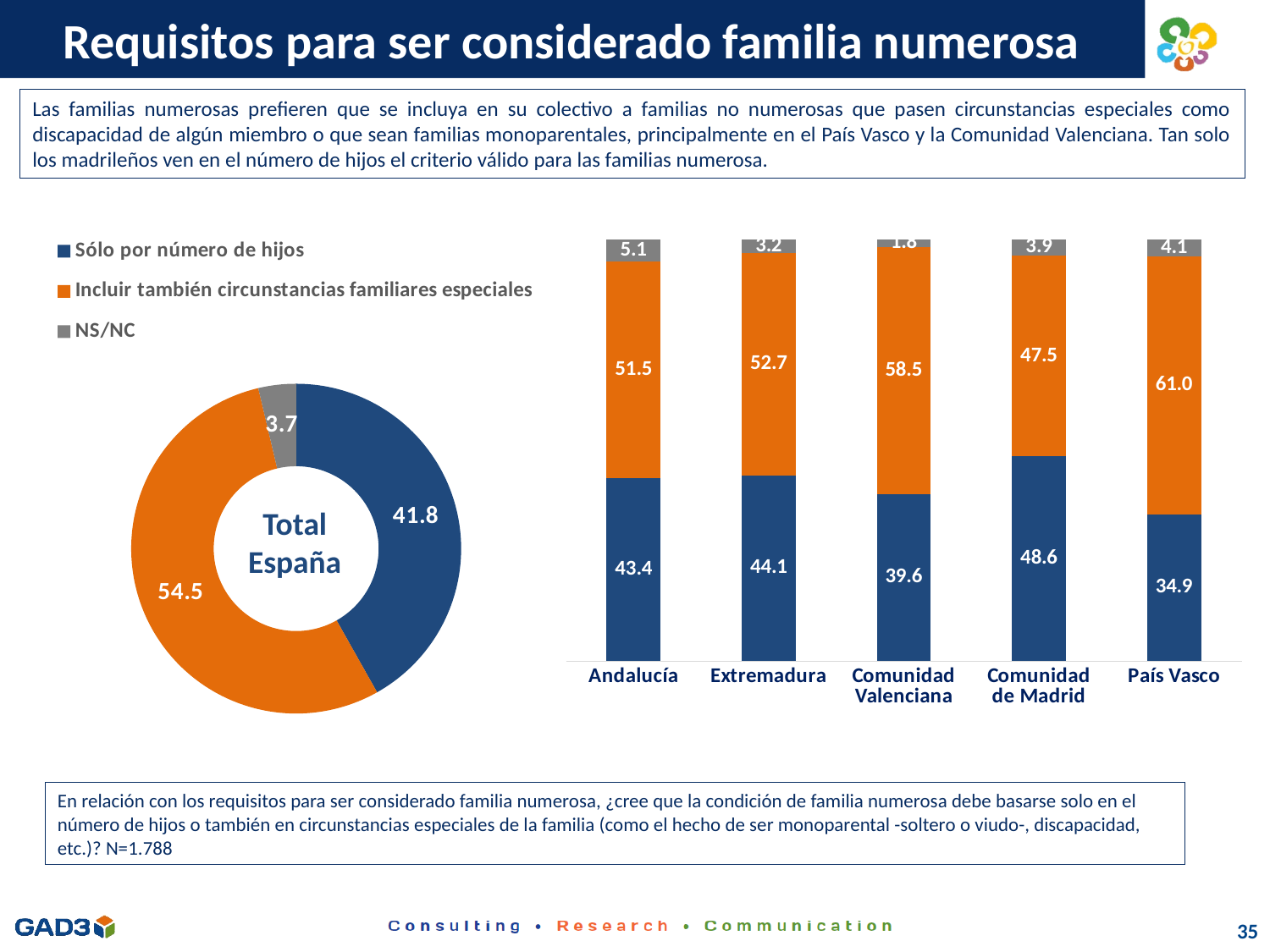
In the stacked bar chart on the right, what is the value for 'Sólo por número de hijos' in País Vasco? 34.9 In the stacked bar chart on the right, what is the value for 'Incluir también circunstancias familiares especiales' in Comunidad Valenciana? 58.5 In the stacked bar chart on the right, which region has the lowest value for 'Incluir también circunstancias familiares especiales'? Comunidad de Madrid What kind of chart is the chart on the right of the slide? Stacked bar chart How many regions are shown on the x axis of the stacked bar chart on the right? 5 In the stacked bar chart on the right, what is the difference between the 'Incluir también circunstancias familiares especiales' values for País Vasco and Comunidad de Madrid? 13.5 In the donut chart labelled Total España, what is the value for 'Sólo por número de hijos'? 41.8 In the stacked bar chart on the right, which region has the highest value for 'Sólo por número de hijos'? Comunidad de Madrid In the donut chart labelled Total España, what is the value for NS/NC? 3.7 In the stacked bar chart on the right, which is larger in Comunidad de Madrid: 'Sólo por número de hijos' or 'Incluir también circunstancias familiares especiales'? Sólo por número de hijos In the donut chart labelled Total España, what is the value for 'Incluir también circunstancias familiares especiales'? 54.5 How many series does the legend list? 3